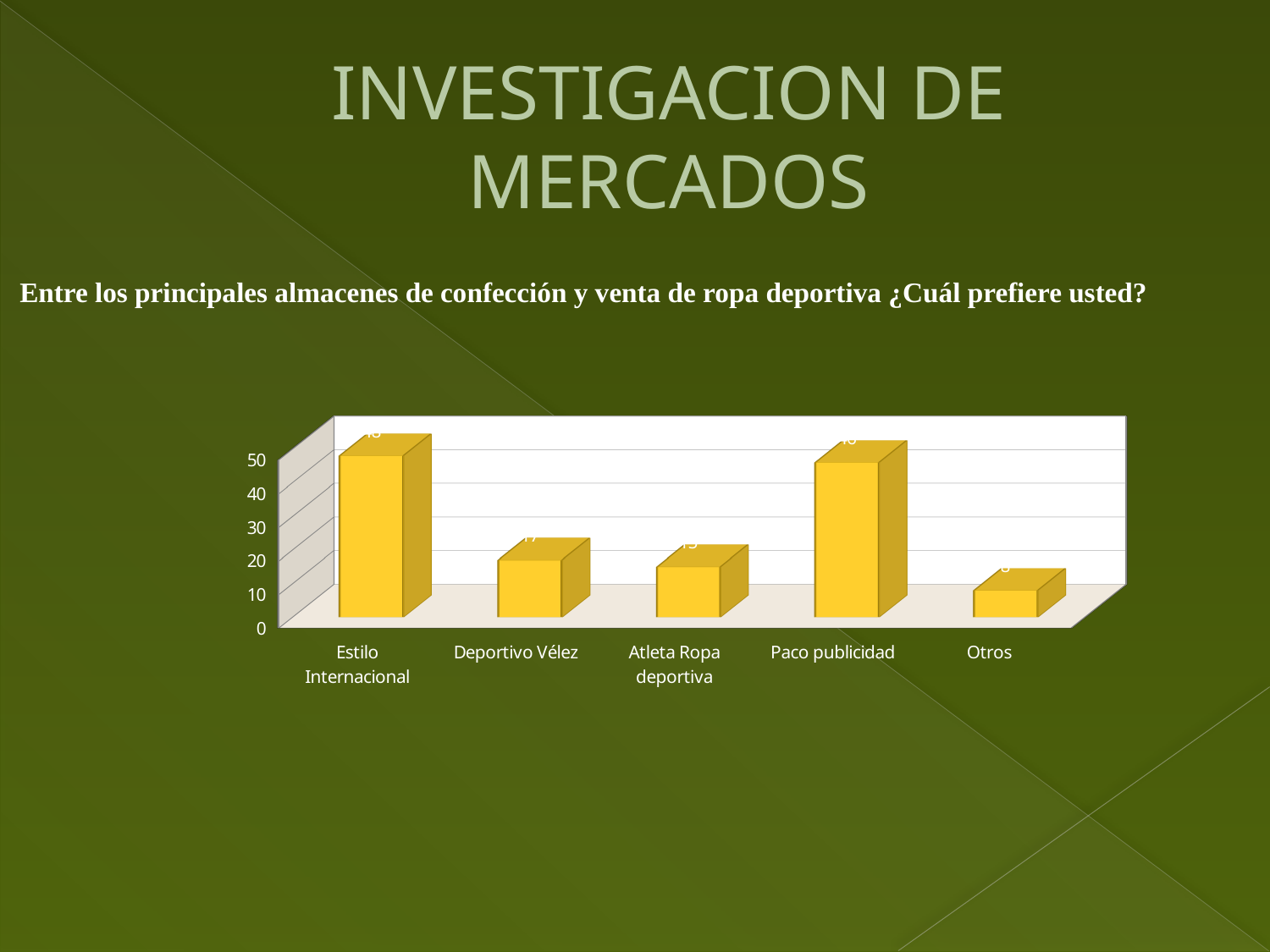
What is the highest tick value shown on the vertical axis of the chart? 50 What colour are the bars in the chart? yellow Which category has the lowest value in the chart? Otros Is the value for Estilo Internacional greater or less than 40? greater Which is larger, the value for Paco publicidad or the value for Otros? Paco publicidad Is the value for Atleta Ropa deportiva greater or less than 30? less Is the value for Deportivo Vélez greater or less than 30? less What kind of chart is shown on the slide? bar chart Which is larger, the value for Estilo Internacional or the value for Deportivo Vélez? Estilo Internacional How many categories (stores) are shown on the x axis of the chart? 5